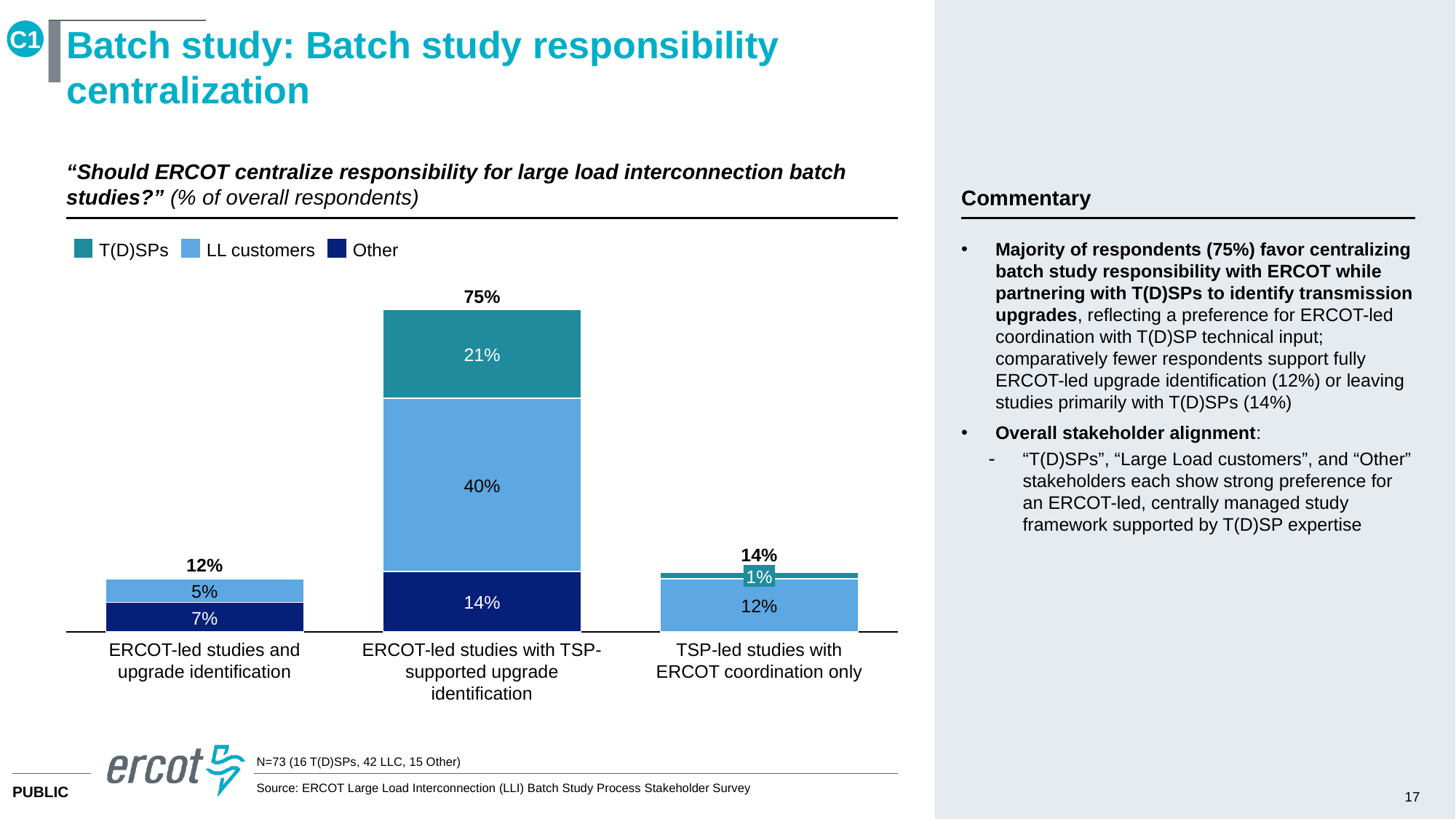
What is the Other value for 'ERCOT-led studies and upgrade identification'? 7% Which category has the highest total? ERCOT-led studies with TSP-supported upgrade identification How many series does the legend list? 3 Which category has the lowest total? ERCOT-led studies and upgrade identification What is the difference between the totals for 'ERCOT-led studies with TSP-supported upgrade identification' and 'TSP-led studies with ERCOT coordination only'? 61% What is the total for the 'ERCOT-led studies with TSP-supported upgrade identification' bar? 75% Which is larger: the LL customers value for 'ERCOT-led studies and upgrade identification' or the LL customers value for 'TSP-led studies with ERCOT coordination only'? TSP-led studies with ERCOT coordination only What is the LL customers value for 'ERCOT-led studies with TSP-supported upgrade identification'? 40% How many categories are shown on the x axis? 3 What kind of chart is shown on the slide? Stacked bar chart What is the T(D)SPs value for 'TSP-led studies with ERCOT coordination only'? 1% Which legend entry is shown in the darkest blue colour? Other